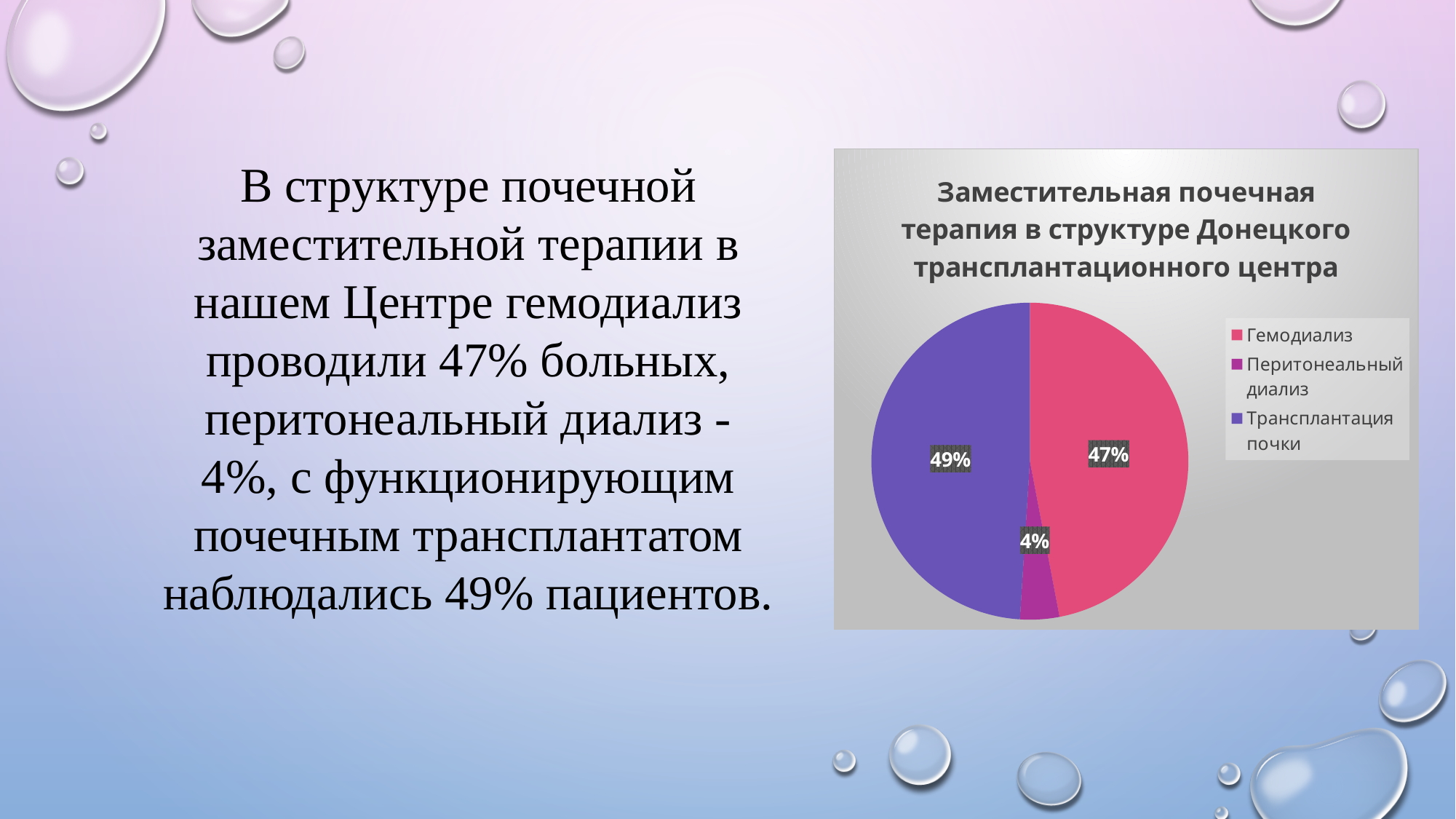
What is the value for Гемодиализ in the pie chart? 47% What kind of chart is shown on the slide? pie chart What is the value for Перитонеальный диализ in the pie chart? 4% Which category has the largest share of the pie? Трансплантация почки What is the difference between the shares of Гемодиализ and Перитонеальный диализ? 43% Which category has the smallest share of the pie? Перитонеальный диализ How many slices does the pie chart have? 3 What is the difference between the shares of Трансплантация почки and Гемодиализ? 2% Which colour represents Трансплантация почки in the legend? purple What is the value for Трансплантация почки in the pie chart? 49% Which is larger: the share for Гемодиализ or the share for Перитонеальный диализ? Гемодиализ What is the title of the chart? Заместительная почечная терапия в структуре Донецкого трансплантационного центра